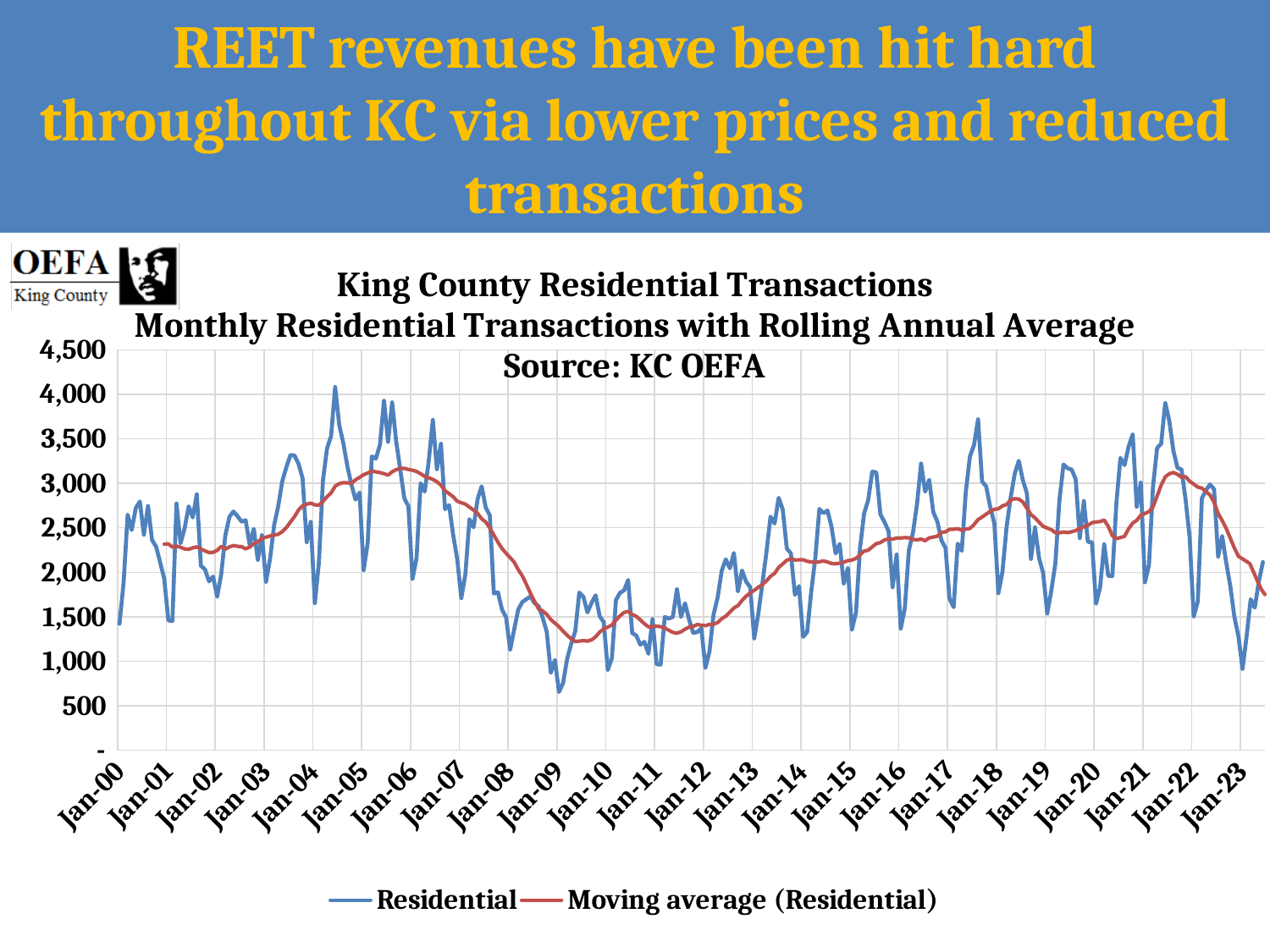
How many series does the legend list? 2 How many year labels are shown on the x axis? 24 What is the source given in the chart title? KC OEFA Is the Moving average (Residential) value at Jan-09 greater or less than 1,500? less Is the Moving average (Residential) value at Jan-12 greater or less than 2,000? less Does the Moving average (Residential) line rise or fall between Jan-22 and Jan-23? fall What are the two series named in the legend? Residential; Moving average (Residential) Is the Moving average (Residential) value at Jan-06 greater or less than 3,000? greater What kind of chart is shown on the slide? Line chart What is the highest value shown on the y axis? 4,500 Does the Moving average (Residential) line rise or fall between Jan-12 and Jan-18? rise Does the Moving average (Residential) line rise or fall between Jan-06 and Jan-09? fall